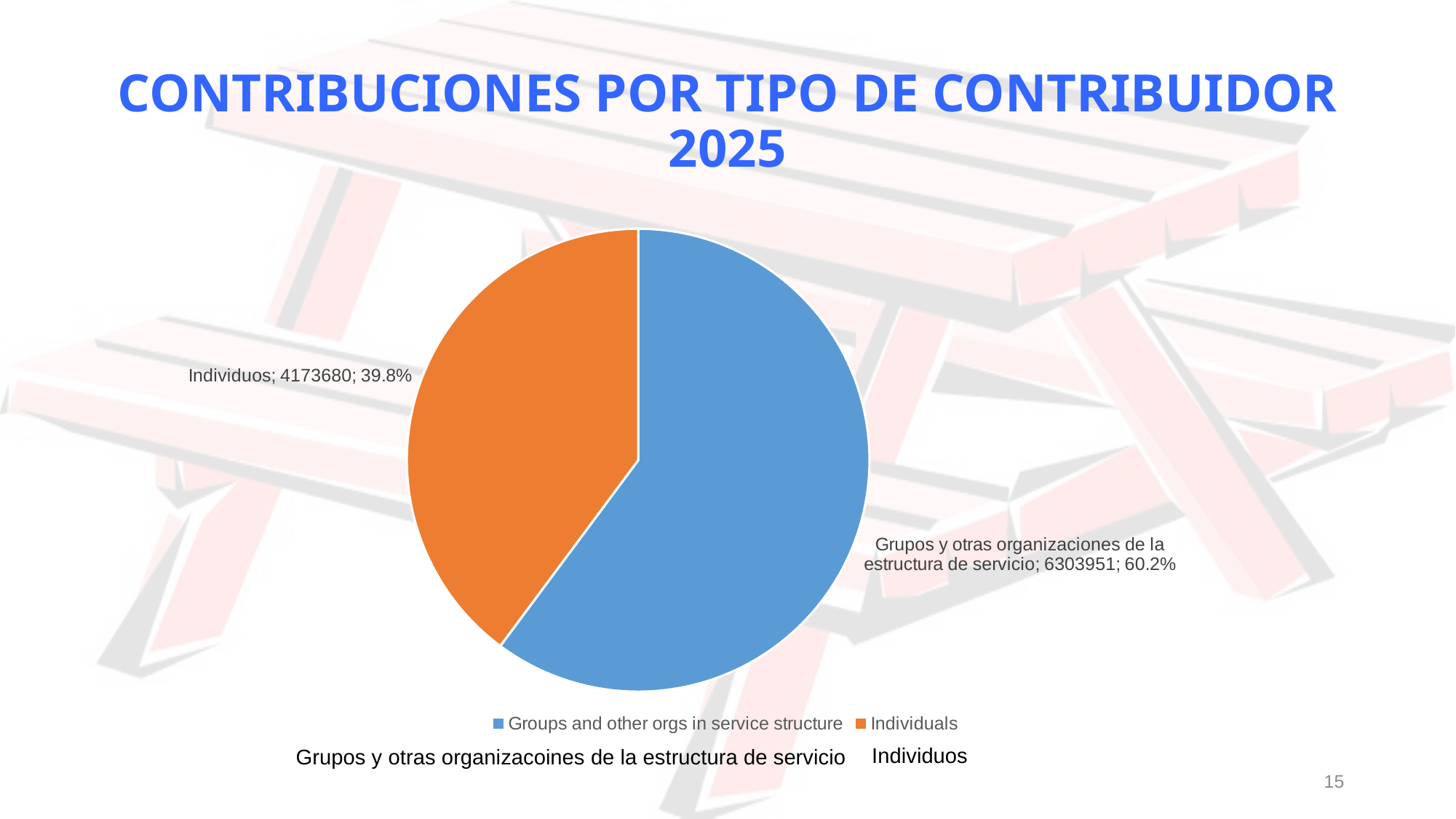
What is the value for Grupos y otras organizaciones de la estructura de servicio? 6303951 Which is larger, the value for Individuos or the value for Grupos y otras organizaciones de la estructura de servicio? Grupos y otras organizaciones de la estructura de servicio How many slices does the pie chart have? 2 Which category has the largest slice of the pie? Grupos y otras organizaciones de la estructura de servicio What is the difference between the value for Grupos y otras organizaciones de la estructura de servicio and the value for Individuos? 2130271 How many entries does the legend list? 2 What kind of chart is shown on the slide? Pie chart Which category has the smallest slice of the pie? Individuos What share of the pie does the Individuos slice represent? 39.8% What colour is the Individuals slice in the pie chart? Orange What is the value for Individuos? 4173680 What share of the pie does the Grupos y otras organizaciones de la estructura de servicio slice represent? 60.2%